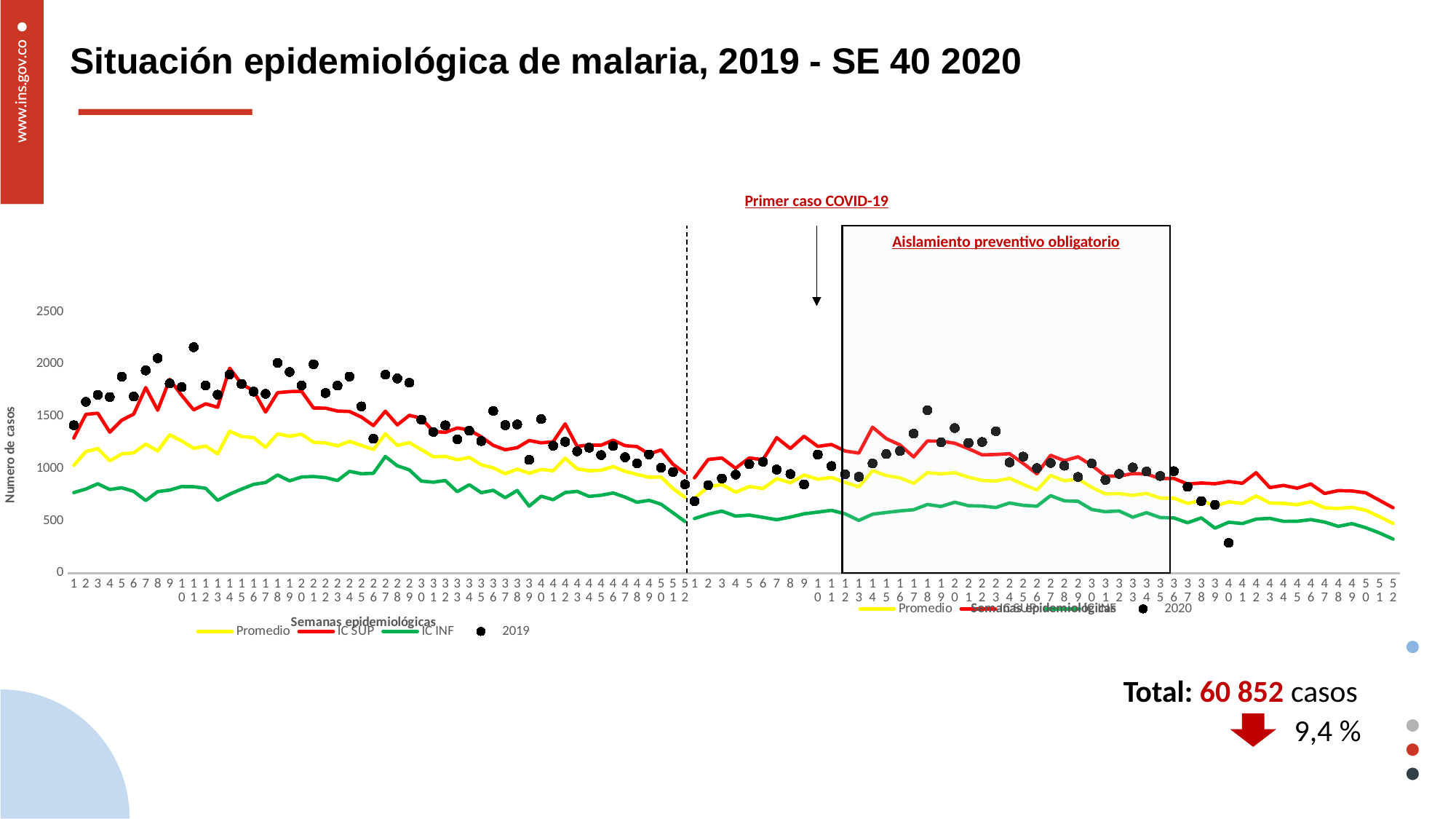
In the 2019 chart, is the value of the 2019 dot at week 52 greater or less than 1000? less What is the title of the slide's chart? Situación epidemiológica de malaria, 2019 - SE 40 2020 In the 2020 chart, at which epidemiological week does the 2020 series reach its lowest value? 40 In the 2019 chart, at which epidemiological week does the 2019 series reach its highest value? 11 In the 2019 chart, is the value of the 2019 dot at week 11 greater or less than 2000? greater In the 2019 chart, which is larger: the 2019 dot at week 9 or the 2019 dot at week 30? week 9 In the 2020 chart, is the value of the 2020 dot at week 40 greater or less than 500? less In the 2019 chart, do the 2019 dots overall rise or fall from week 1 to week 52? fall How many series does the legend of the left (2019) chart list? 4 Which series is drawn in red in the chart? IC SUP What kind of chart is shown on the slide? line chart with scatter points